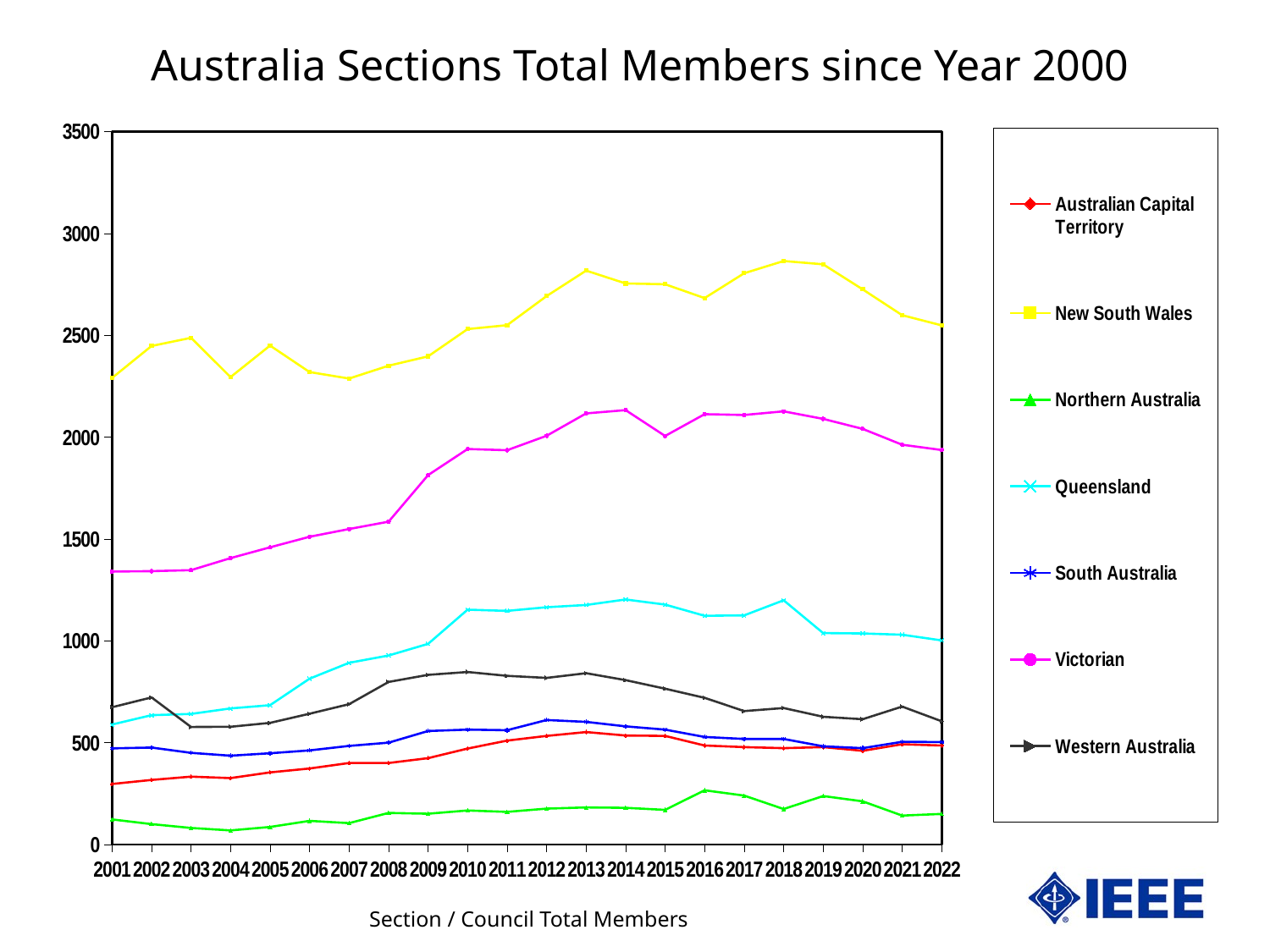
Which section has the highest number of members in 2022? New South Wales Is the value for New South Wales in 2018 greater or less than 2500? greater Is the value for Victorian in 2001 greater or less than 1500? less Do the values for Victorian rise or fall from 2001 to 2013? rise Do the values for New South Wales rise or fall from 2018 to 2022? fall Is the value for Queensland in 2014 greater or less than 1000? greater How many series does the legend list? 7 How many years are plotted along the x axis? 22 Which is larger in 2022, Queensland or Western Australia? Queensland What kind of chart is shown on the slide? line chart What is the title of the chart? Australia Sections Total Members since Year 2000 Which section has the lowest number of members in 2022? Northern Australia